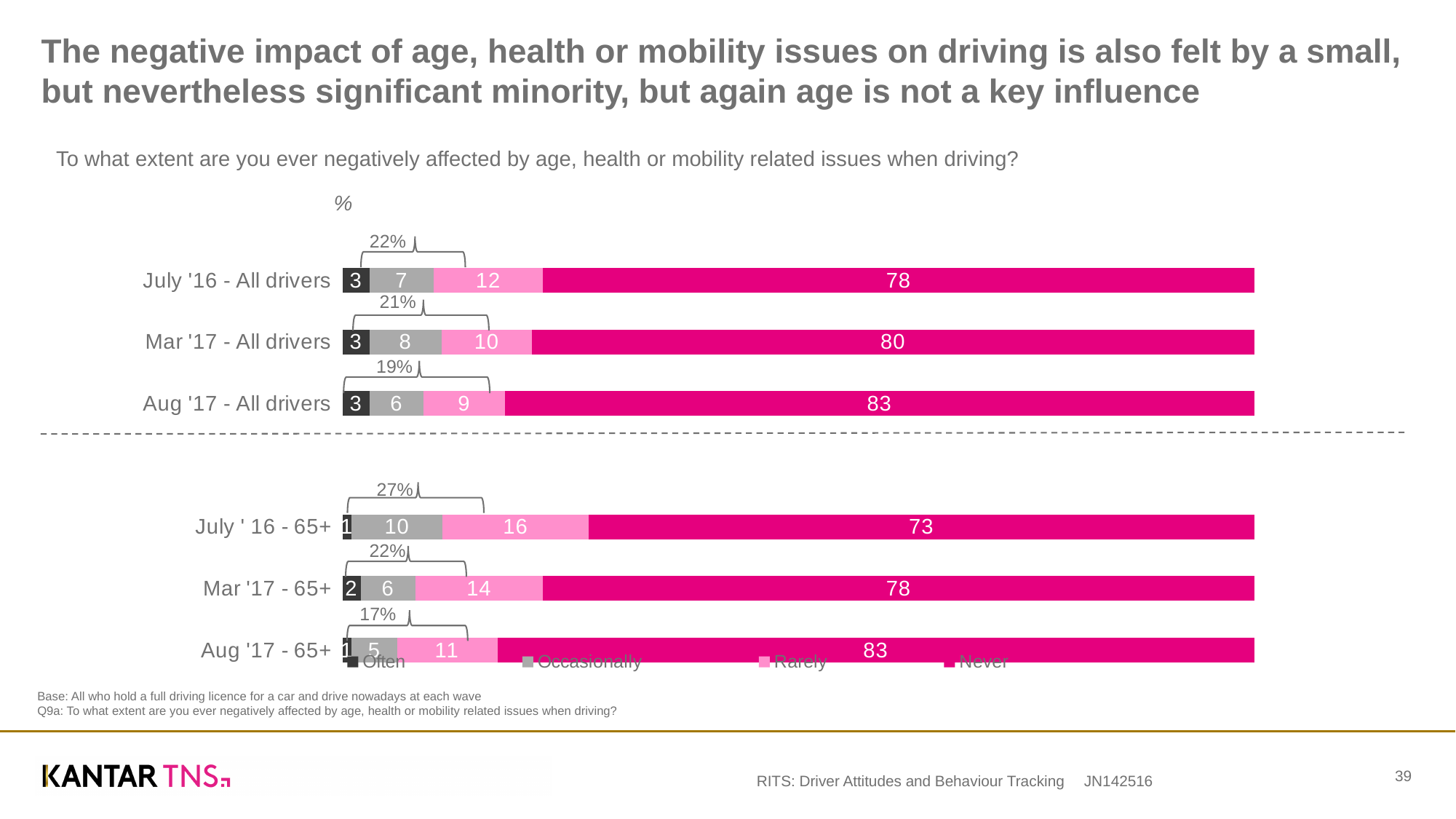
How many series does the legend list? 4 How many categories (bars) are shown in the chart? 6 What is the 'Rarely' value for July '16 - 65+? 16 What is the 'Never' value for Aug '17 - All drivers? 83 What is the 'Occasionally' value for Mar '17 - All drivers? 8 Which is larger, the 'Occasionally' value for July '16 - 65+ or for Mar '17 - 65+? July ' 16 - 65+ Which category has the highest 'Rarely' value? July ' 16 - 65+ What is the 'Often' value for Mar '17 - 65+? 2 What kind of chart is shown on the slide? Stacked bar chart What is the difference between the 'Never' values for Mar '17 - All drivers and July '16 - All drivers? 2 Which category has the lowest 'Never' value? July ' 16 - 65+ What bracketed percentage is shown above the Aug '17 - 65+ bar? 17%